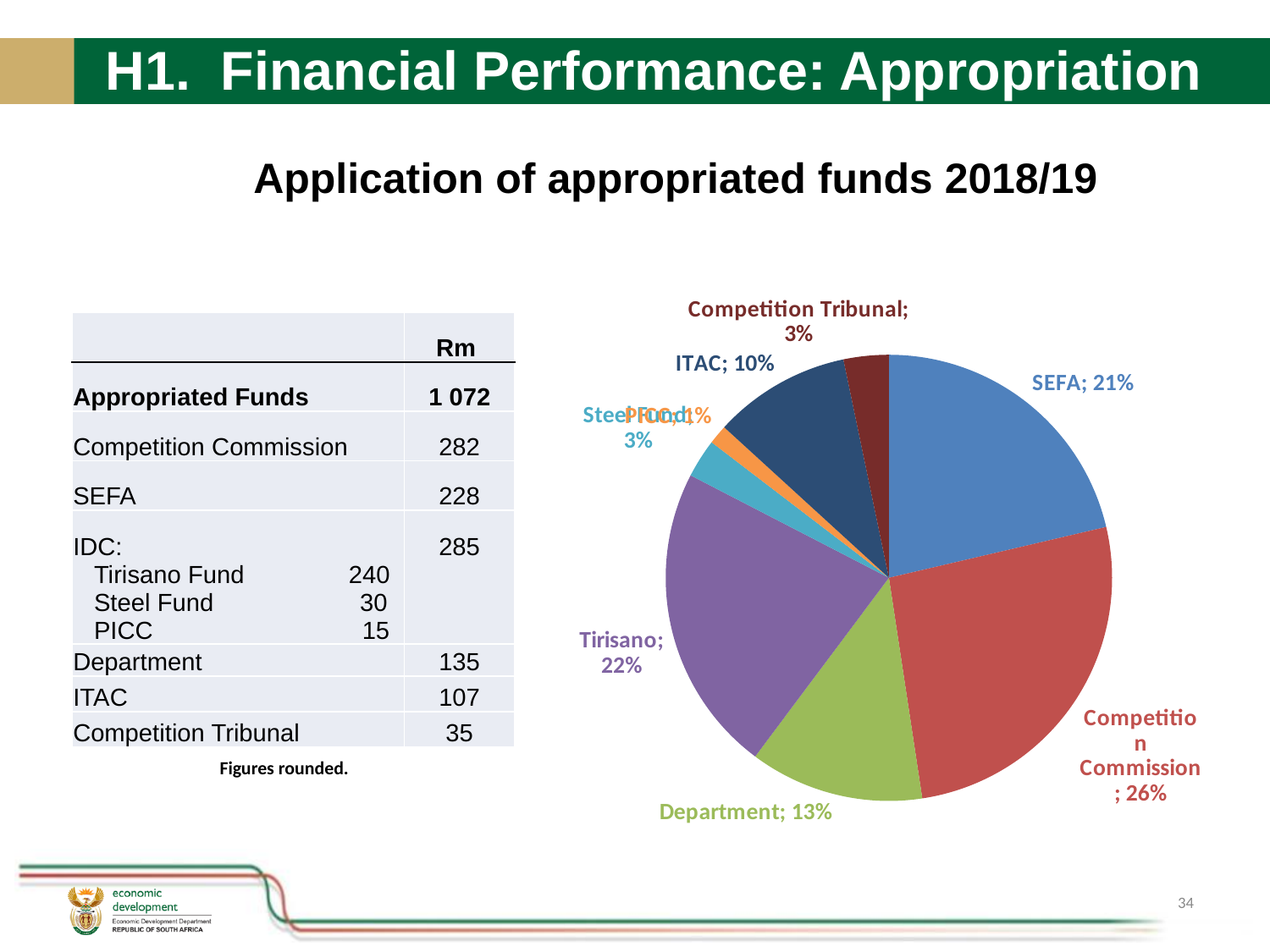
How many slices does the pie chart have? 8 What percentage is shown for the Competition Commission slice? 26% Which slice of the pie chart is the largest? Competition Commission By how many percentage points does the Competition Commission share exceed the Department share? 13 percentage points What percentage does the Department slice show? 13% What share of the pie does SEFA account for? 21% What share is shown for ITAC in the pie chart? 10% What share of the pie is labelled for Tirisano? 22% What percentage is labelled for the Competition Tribunal slice? 3% Which has the larger share in the pie chart, SEFA or Tirisano? Tirisano What colour is the SEFA slice in the pie chart? blue What kind of chart is shown on the slide? pie chart